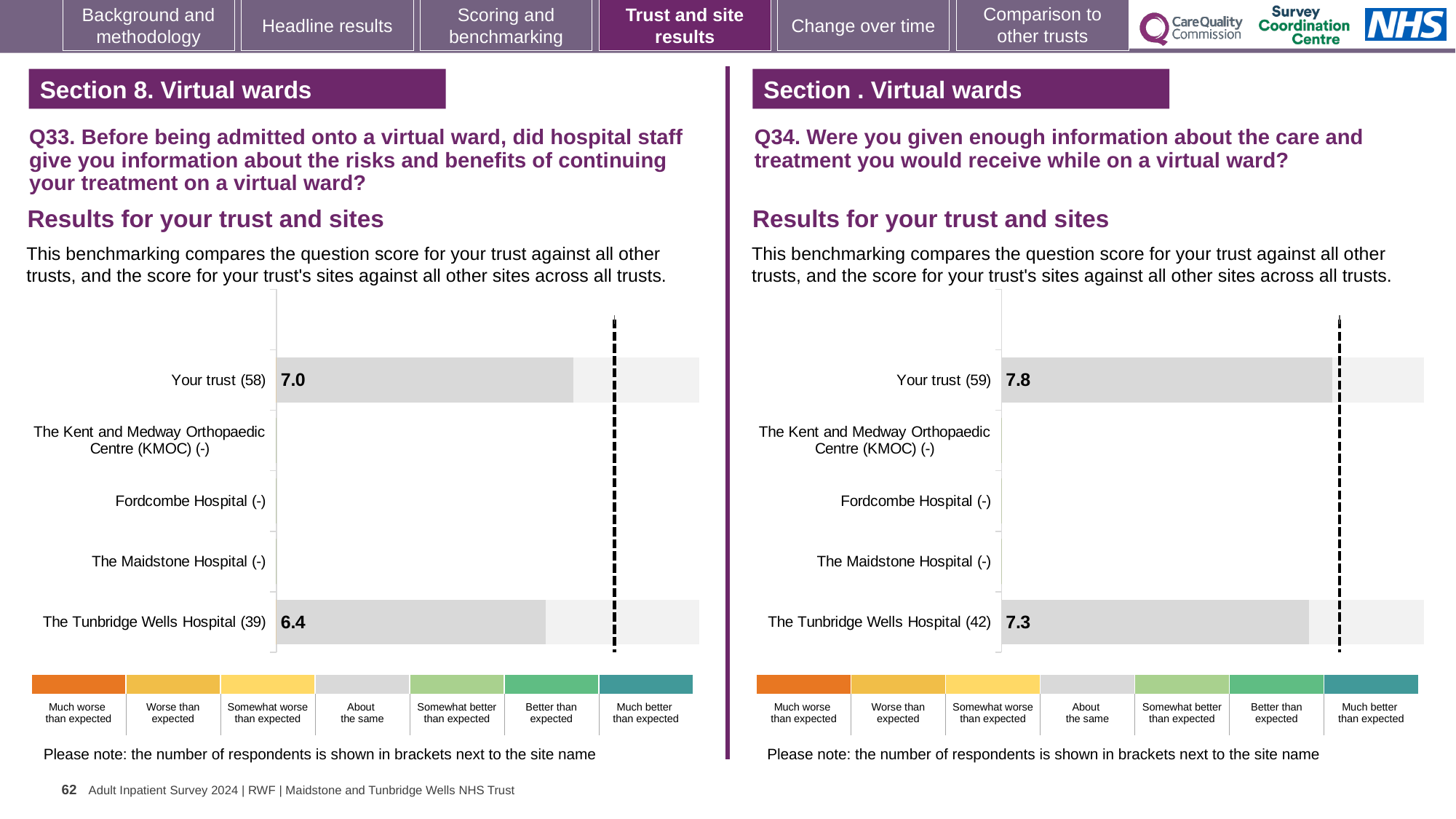
What kind of chart is the Q34 chart on the right? Bar chart How many site/trust categories are listed on the y axis of the Q33 chart on the left? 5 In the Q33 chart on the left, what is the score for Your trust (58)? 7.0 In the Q34 chart on the right, what is the difference between the score for Your trust and the score for The Tunbridge Wells Hospital? 0.5 In the Q33 chart on the left, which has the higher score, Your trust or The Tunbridge Wells Hospital? Your trust In the Q34 chart on the right, what is the score for The Tunbridge Wells Hospital (42)? 7.3 In the Q34 chart on the right, which has the lower score, Your trust or The Tunbridge Wells Hospital? The Tunbridge Wells Hospital In the Q33 chart on the left, what is the difference between the score for Your trust and the score for The Tunbridge Wells Hospital? 0.6 In the Q33 chart on the left, what is the score for The Tunbridge Wells Hospital (39)? 6.4 In the Q34 chart on the right, how many respondents are shown in brackets for Your trust? 59 In the Q33 chart on the left, how many respondents are shown in brackets for The Tunbridge Wells Hospital? 39 In the Q34 chart on the right, what is the score for Your trust (59)? 7.8